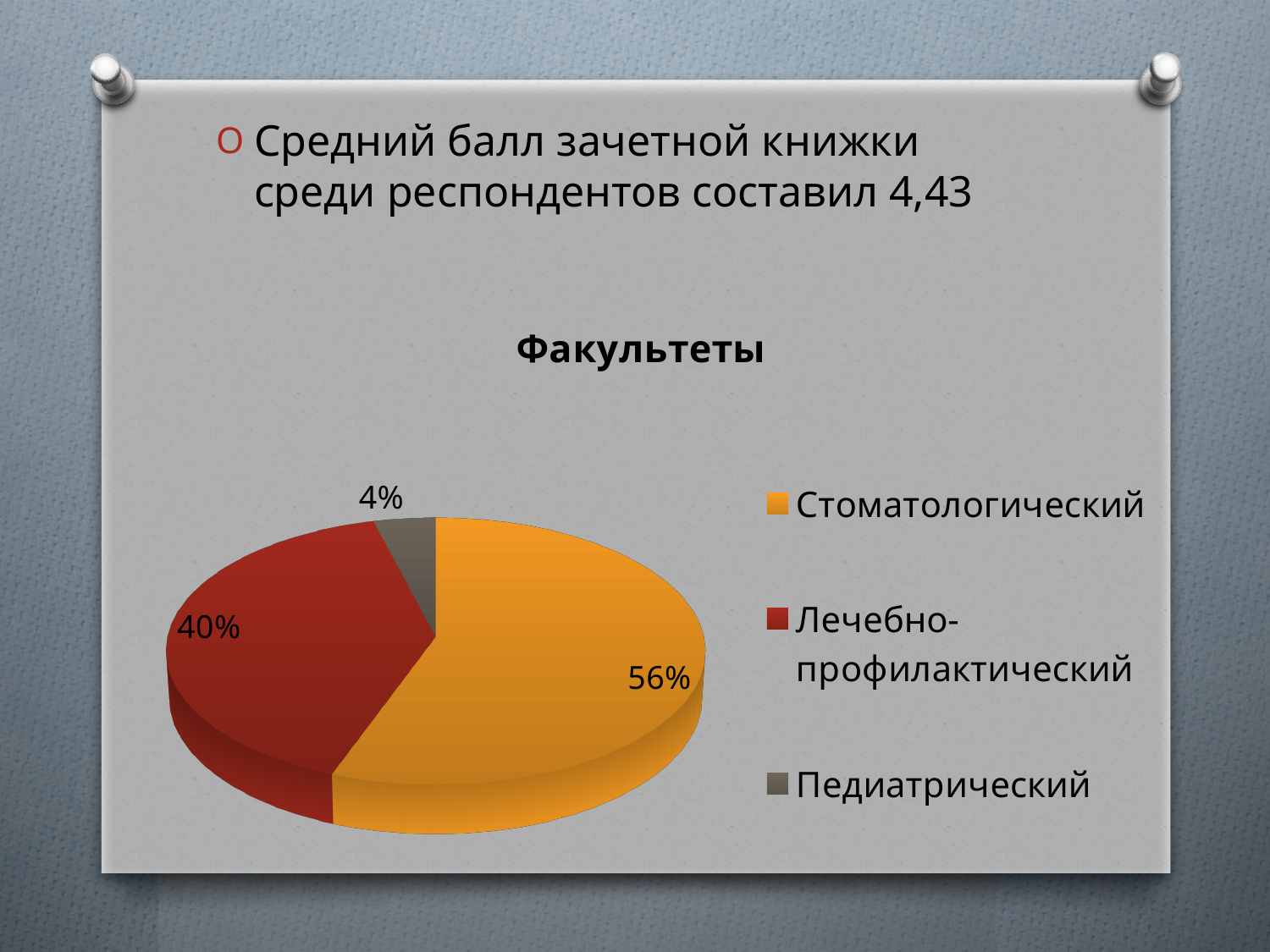
What share of the pie does Педиатрический have? 4% What share of the pie does Лечебно-профилактический have? 40% What share of the pie does Стоматологический have? 56% What is the difference in percentage points between Стоматологический and Лечебно-профилактический? 16 Which faculty has the smallest share of the pie? Педиатрический Which is larger, the share for Лечебно-профилактический or the share for Педиатрический? Лечебно-профилактический What is the title of the chart? Факультеты What colour is the slice for Педиатрический? grey How many slices does the pie chart have? 3 How many entries does the legend list? 3 What type of chart is shown on the slide? pie chart Which faculty has the largest share of the pie? Стоматологический